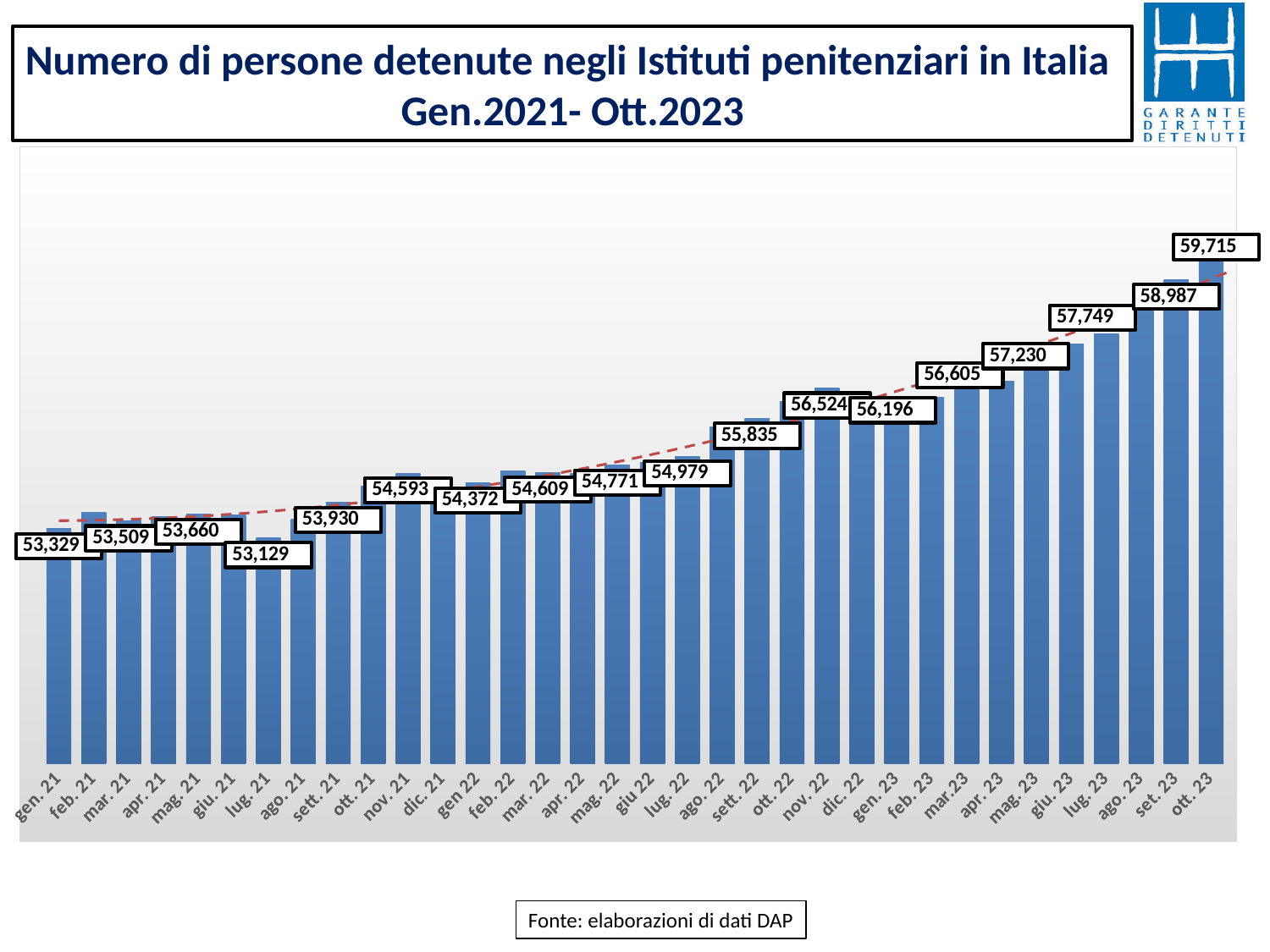
Which month has the lowest number of detained persons? lug. 21 What is the number of detained persons shown for set. 23? 58,987 What is the difference between the values for ott. 23 and gen. 21? 6,386 How many months (bars) are plotted on the chart? 34 What is the number of detained persons shown for gen. 21? 53,329 What is the number of detained persons shown for ott. 23? 59,715 What is the number of detained persons shown for lug. 21? 53,129 What kind of chart is shown on the slide? bar chart Do the values generally rise or fall from gen. 21 to ott. 23? rise What is the title of the chart? Numero di persone detenute negli Istituti penitenziari in Italia Gen.2021- Ott.2023 Which is larger, the value for ott. 23 or the value for gen. 21? ott. 23 Which month has the highest number of detained persons? ott. 23